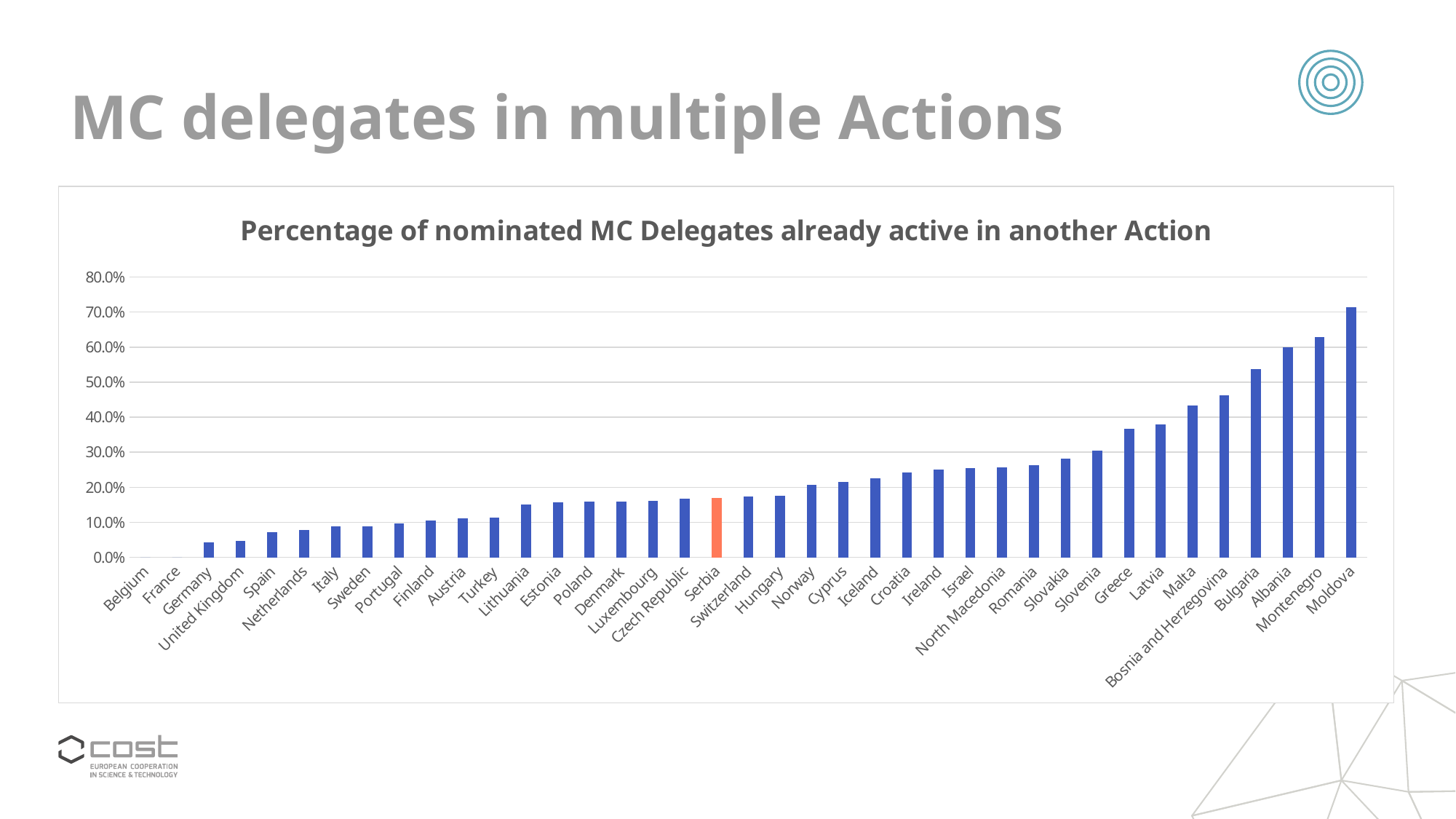
How many countries are shown on the x axis? 39 What kind of chart is shown on the slide? Bar chart Is the value for Bulgaria greater or less than 50.0%? greater Is the value for Serbia greater or less than 20.0%? less Is the value for Germany greater or less than 10.0%? less Which has the larger value, Greece or Serbia? Greece Which has the larger value, Moldova or Albania? Moldova Which country has the highest percentage of nominated MC Delegates already active in another Action? Moldova What is the title of the chart? Percentage of nominated MC Delegates already active in another Action Which country is highlighted with an orange bar? Serbia Do the values rise or fall from left to right along the x axis? Rise